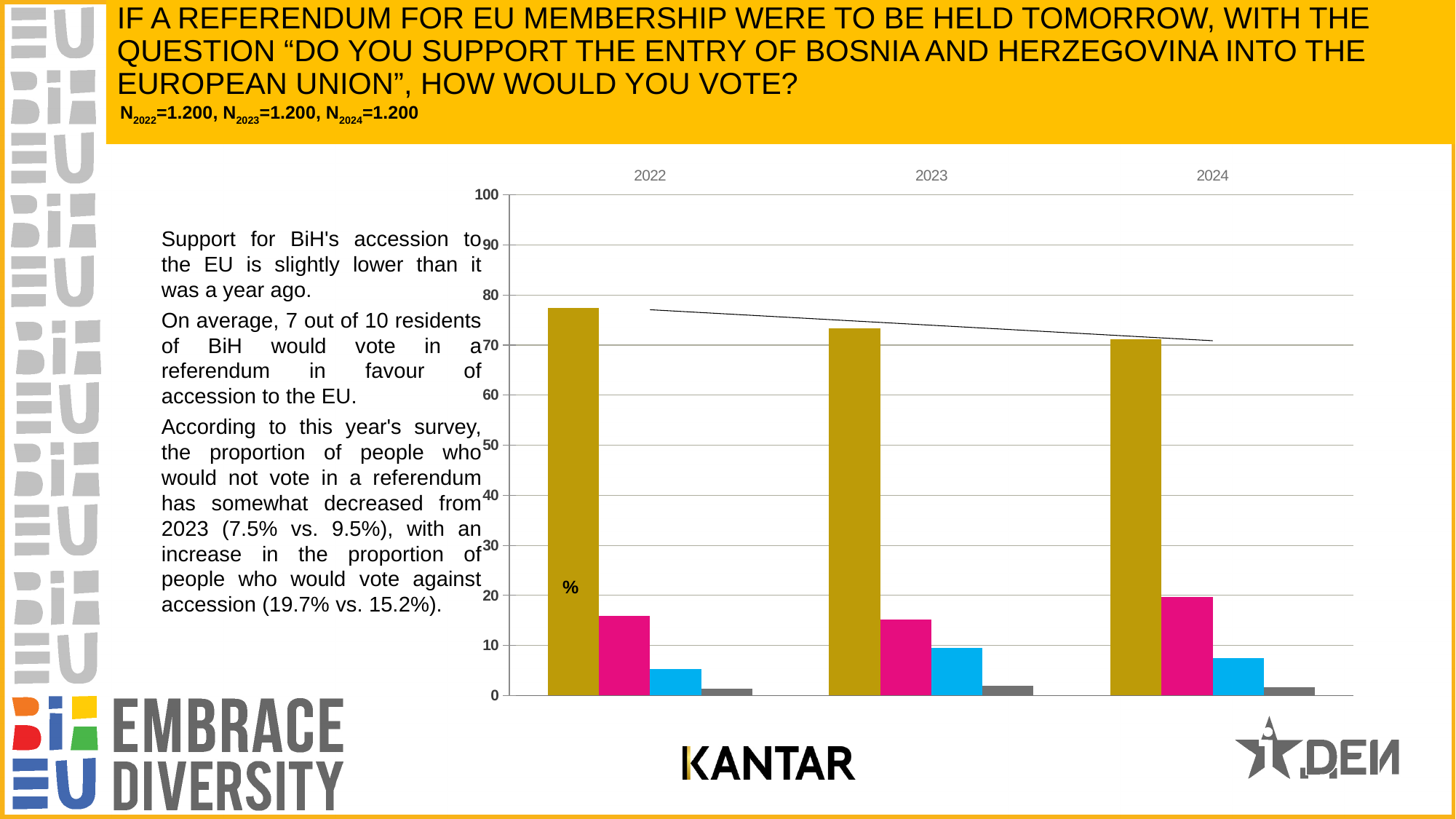
Is the magenta bar larger in 2023 or in 2024? 2024 What is the highest value shown on the vertical axis of the chart? 100 Is the value of the tallest (gold) bar for 2024 greater or less than 80? less How many years (category groups) are shown on the x axis of the chart? 3 How many bars are plotted for each year group? 4 What kind of chart is shown on the slide? bar chart Is the value of the magenta bar for 2024 greater or less than 10? greater In which year is the gold bar the highest? 2022 Is the value of the blue bar for 2022 greater or less than 10? less Is the blue bar larger in 2023 or in 2024? 2023 Do the gold bars rise or fall from 2022 to 2024? fall